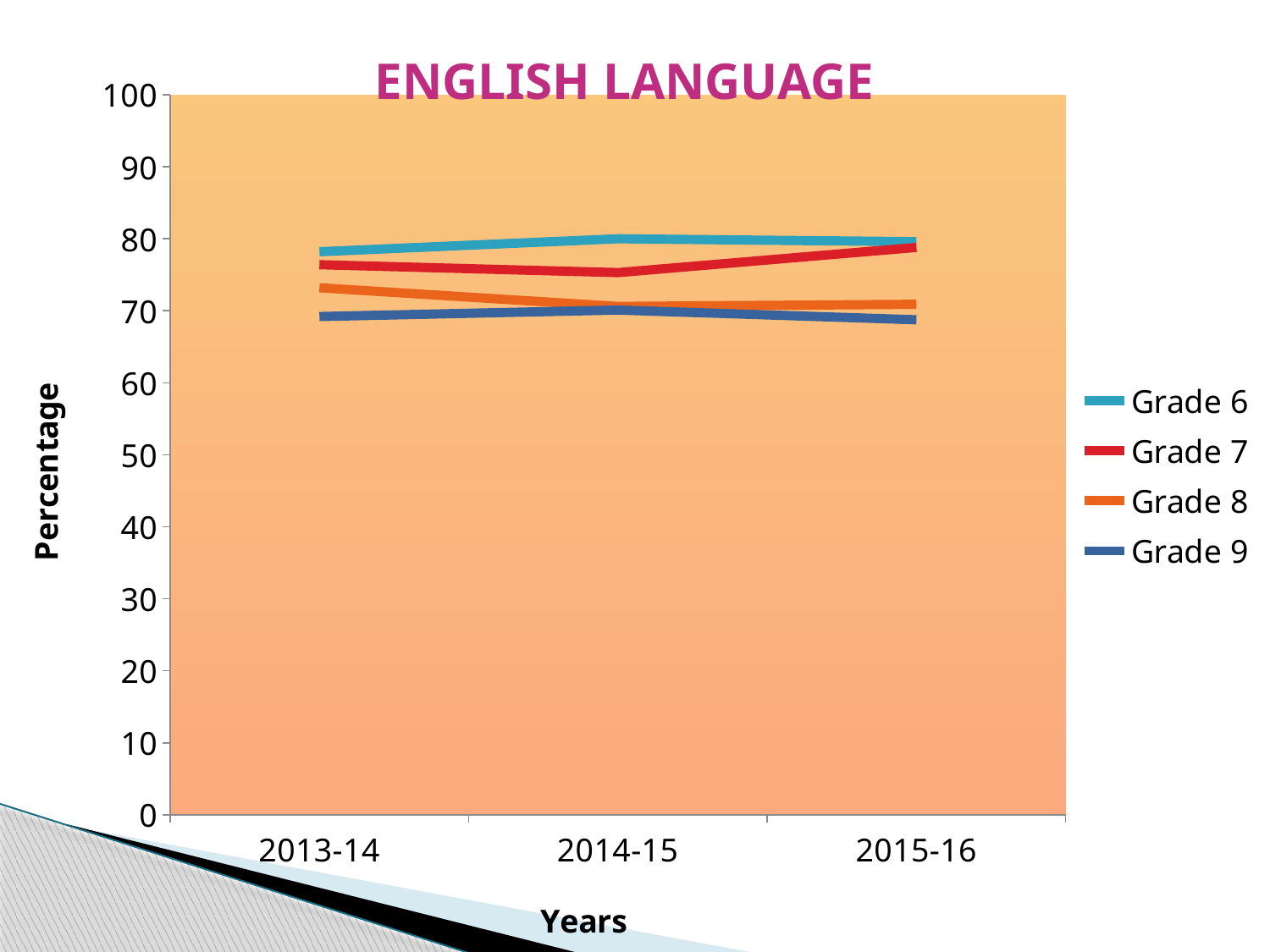
Which grade has the lowest value in 2013-14? Grade 9 How many series does the legend list? 4 Which is larger in 2015-16, Grade 7 or Grade 8? Grade 7 Does the Grade 7 line rise or fall from 2014-15 to 2015-16? rise What is the title of the chart? ENGLISH LANGUAGE Is the value for Grade 9 in 2015-16 greater or less than 80? less Is the value for Grade 6 in 2013-14 greater or less than 70? greater What kind of chart is shown on the slide? line chart How many years are shown on the x axis? 3 Is the value for Grade 7 in 2014-15 greater or less than 80? less What is the label on the vertical axis? Percentage Which is larger in 2013-14, Grade 6 or Grade 9? Grade 6